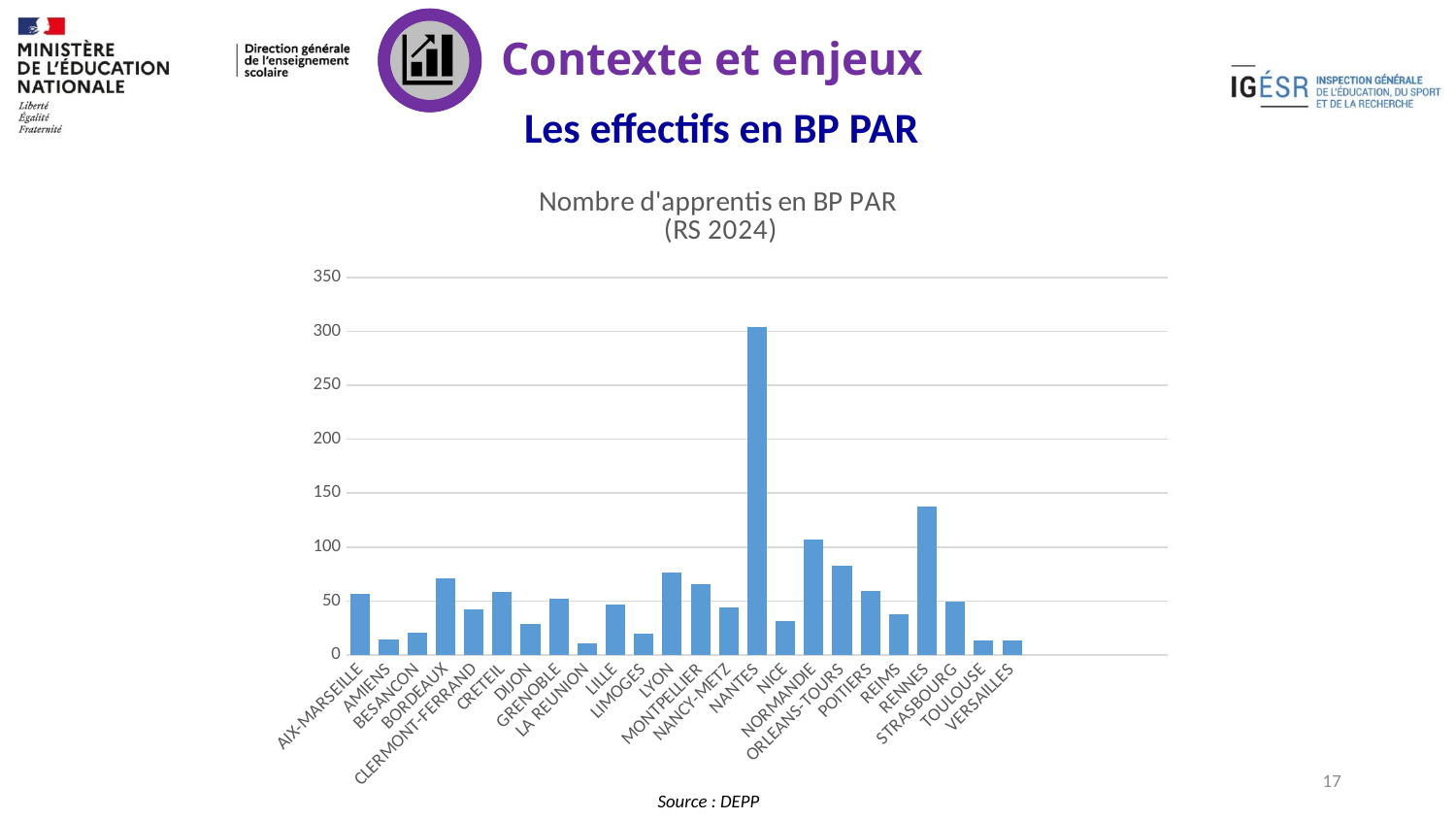
What is the title of the chart? Nombre d'apprentis en BP PAR (RS 2024) How many academies (categories) are shown on the x axis? 24 Is the value for BORDEAUX greater or less than 50? greater What type of chart is shown on the slide? bar chart Which has a higher value, RENNES or NORMANDIE? RENNES Is the value for NANTES greater or less than 250? greater Is the value for ORLEANS-TOURS greater or less than 100? less Which academy has the highest number of apprentices in BP PAR? NANTES Which has a higher value, BORDEAUX or CLERMONT-FERRAND? BORDEAUX